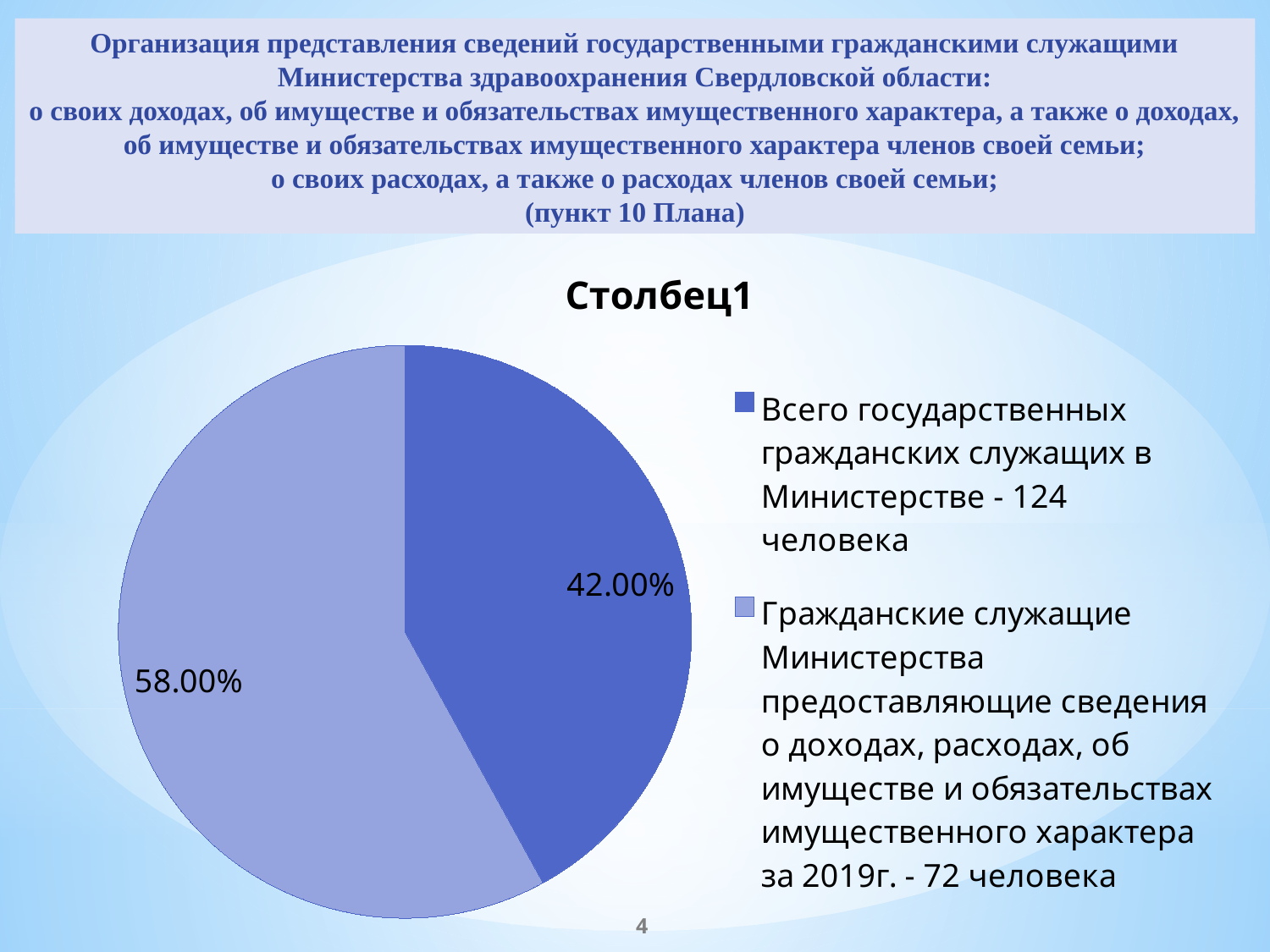
Which slice is the largest in the pie chart? Гражданские служащие Министерства предоставляющие сведения о доходах, расходах, об имуществе и обязательствах имущественного характера за 2019г. - 72 человека How many entries does the legend list? 2 What colour is the slice labelled 42.00%? dark blue Which slice is larger: the one for "Всего государственных гражданских служащих в Министерстве" or the one for "Гражданские служащие Министерства предоставляющие сведения"? Гражданские служащие Министерства предоставляющие сведения What share of the pie does the light blue slice represent? 58.00% What percentage is shown for the slice labelled "Всего государственных гражданских служащих в Министерстве - 124 человека"? 42.00% Which slice is the smallest in the pie chart? Всего государственных гражданских служащих в Министерстве - 124 человека What kind of chart is shown on the slide? pie chart What is the difference in percentage points between the 58.00% slice and the 42.00% slice? 16.00% How many slices does the pie chart have? 2 What is the title of the chart? Столбец1 What percentage is shown for the slice labelled "Гражданские служащие Министерства предоставляющие сведения о доходах, расходах, об имуществе и обязательствах имущественного характера за 2019г. - 72 человека"? 58.00%